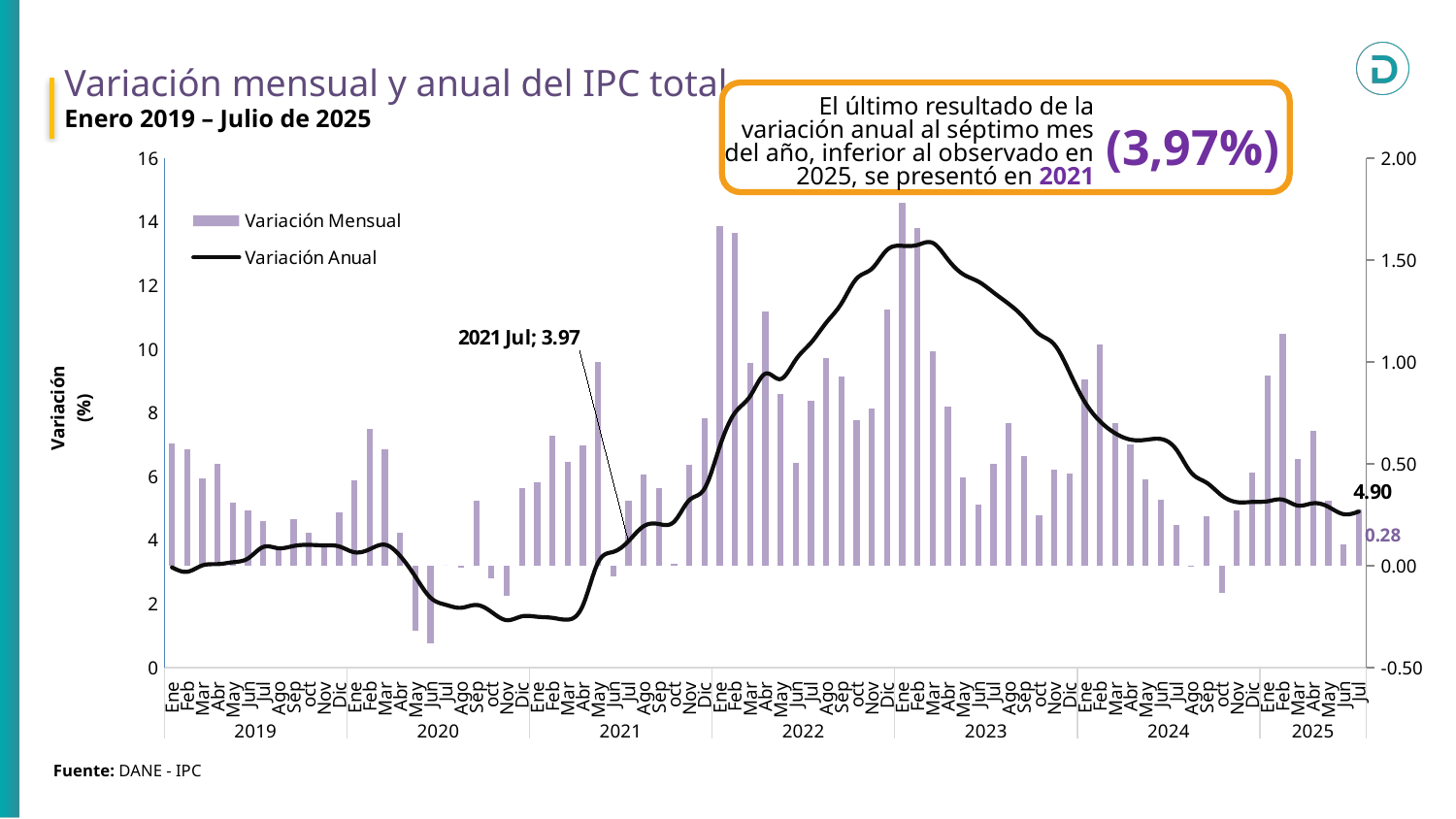
What are the two series named in the legend? Variación Mensual and Variación Anual Is the Variación Anual in June 2020 greater or less than 4? less Is the Variación Anual in March 2023 greater or less than 12? greater Does the Variación Anual line rise or fall between March 2023 and December 2024? fall What kind of chart is shown on the slide? Combined bar and line chart Which is larger, the Variación Anual for July 2025 or for July 2021? July 2025 How many series does the legend list? 2 What is the labelled value of the Variación Anual for July 2021? 3.97 What is the labelled value of the Variación Anual for July 2025? 4.90 What is the difference between the Variación Anual for July 2025 (4.90) and July 2021 (3.97)? 0.93 What is the labelled value of the Variación Mensual for July 2025? 0.28 What is the title of the chart? Variación mensual y anual del IPC total